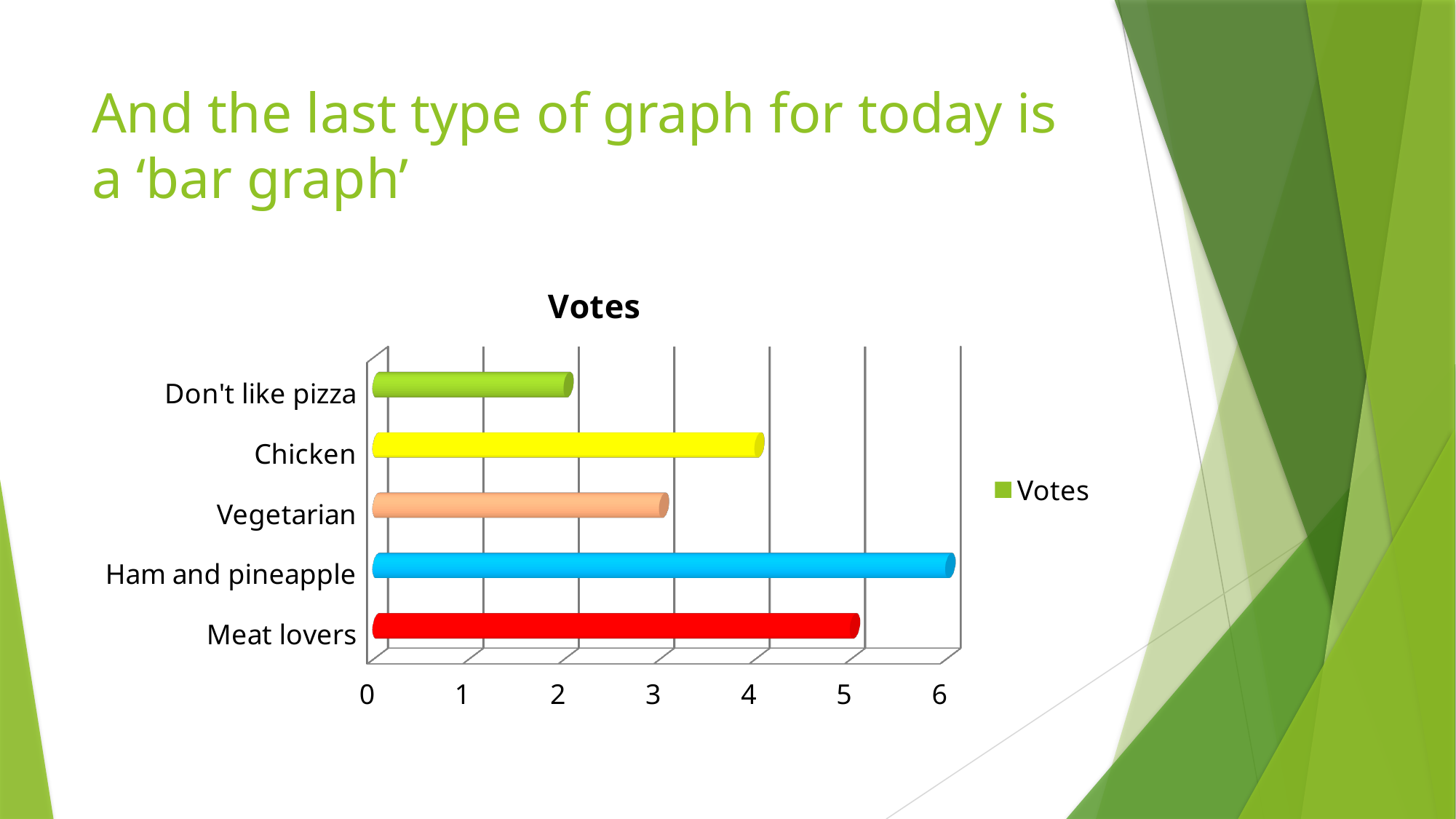
Which received more votes, Chicken or Vegetarian? Chicken What is the difference in votes between Ham and pineapple and Don't like pizza? 4 How many votes did Meat lovers receive? 5 What type of chart is shown on the slide? bar chart Which category has the lowest number of votes? Don't like pizza Which category has the highest number of votes? Ham and pineapple How many votes did Vegetarian receive? 3 How many series does the legend list? 1 How many votes did Ham and pineapple receive? 6 Is the value for Chicken greater or less than 3? greater How many categories are shown in the chart? 5 What is the title of the chart? Votes